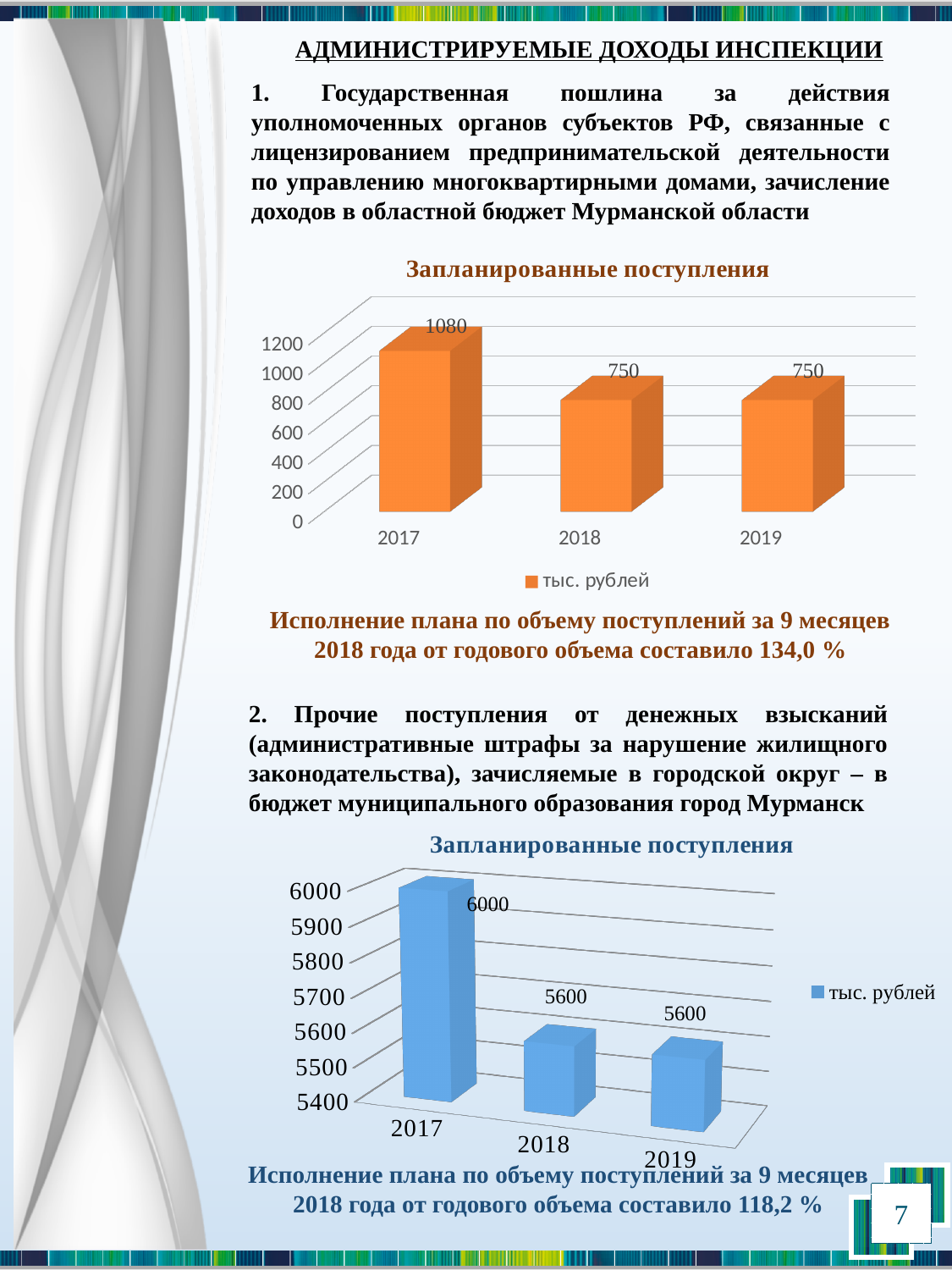
In the top chart (orange bars), is the value for 2018 greater or less than 1000? less In the bottom chart (blue bars), what is the value for 2019? 5600 In the top chart (orange bars), which year has the highest value? 2017 In the top chart (orange bars), what is the value for 2017? 1080 In the bottom chart (blue bars), which is larger, the value for 2017 or the value for 2018? 2017 In the top chart (orange bars), what is the value for 2018? 750 In the bottom chart (blue bars), what is the difference between the values for 2017 and 2018? 400 In the top chart (orange bars), what is the difference between the values for 2017 and 2019? 330 In the top chart (orange bars), how many years are shown on the x axis? 3 What type of chart is the bottom chart (blue bars)? bar chart In the bottom chart (blue bars), what is the value for 2017? 6000 What is the legend entry shown for the top chart (orange bars)? тыс. рублей